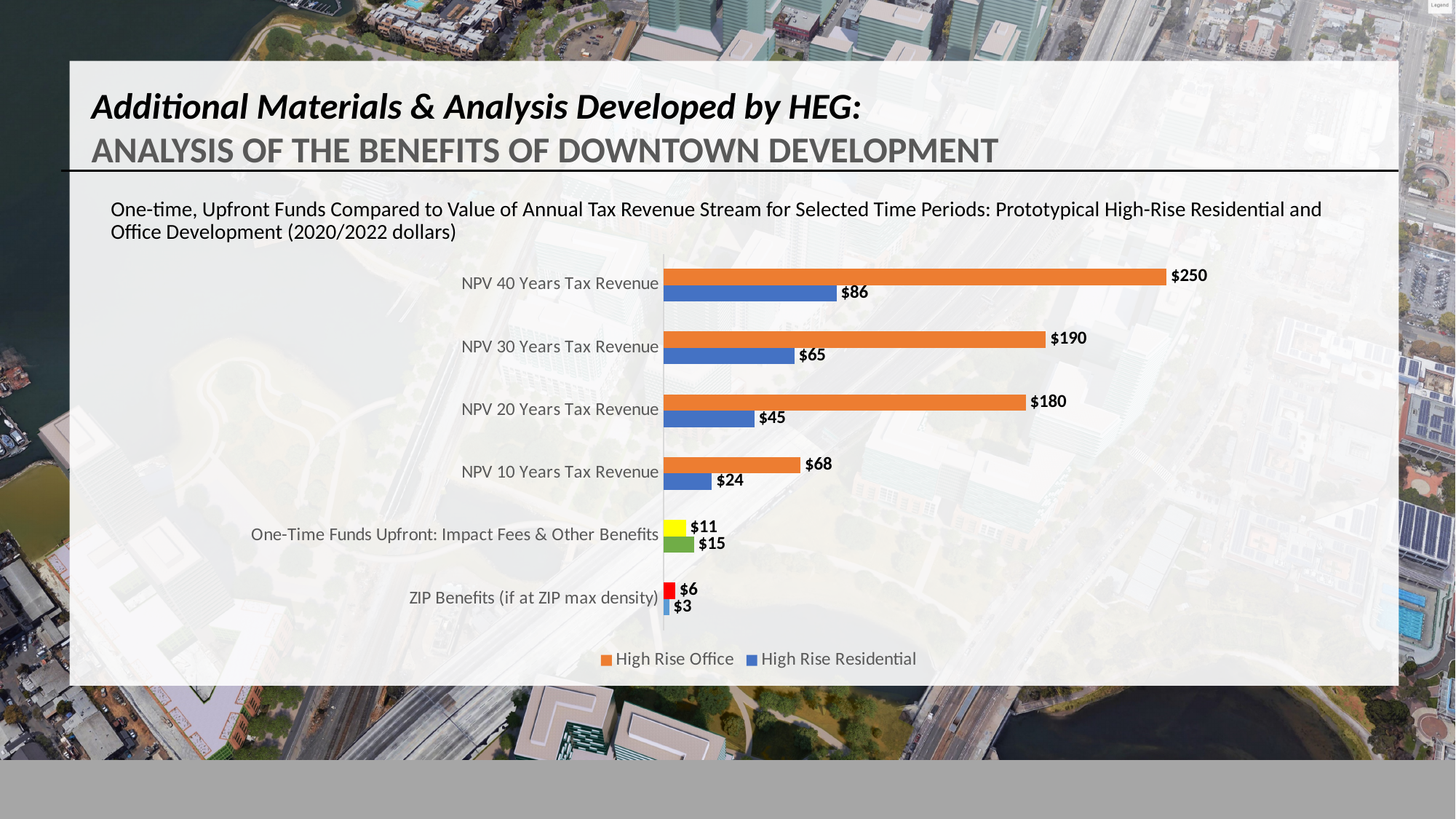
What is the difference between the High Rise Office and High Rise Residential values for NPV 40 Years Tax Revenue? $164 What is the High Rise Office value for NPV 40 Years Tax Revenue? $250 How many categories are shown on the chart? 6 Which is larger for NPV 10 Years Tax Revenue: the High Rise Office value or the High Rise Residential value? High Rise Office How many series does the legend list? 2 What is the High Rise Office value for NPV 20 Years Tax Revenue? $180 Which category has the lowest High Rise Residential value? ZIP Benefits (if at ZIP max density) Which category has the highest High Rise Office value? NPV 40 Years Tax Revenue What is the difference between the High Rise Office values for NPV 30 Years Tax Revenue and NPV 20 Years Tax Revenue? $10 What kind of chart is shown on the slide? Bar chart What is the High Rise Residential value for NPV 30 Years Tax Revenue? $65 What is the High Rise Residential value for NPV 10 Years Tax Revenue? $24